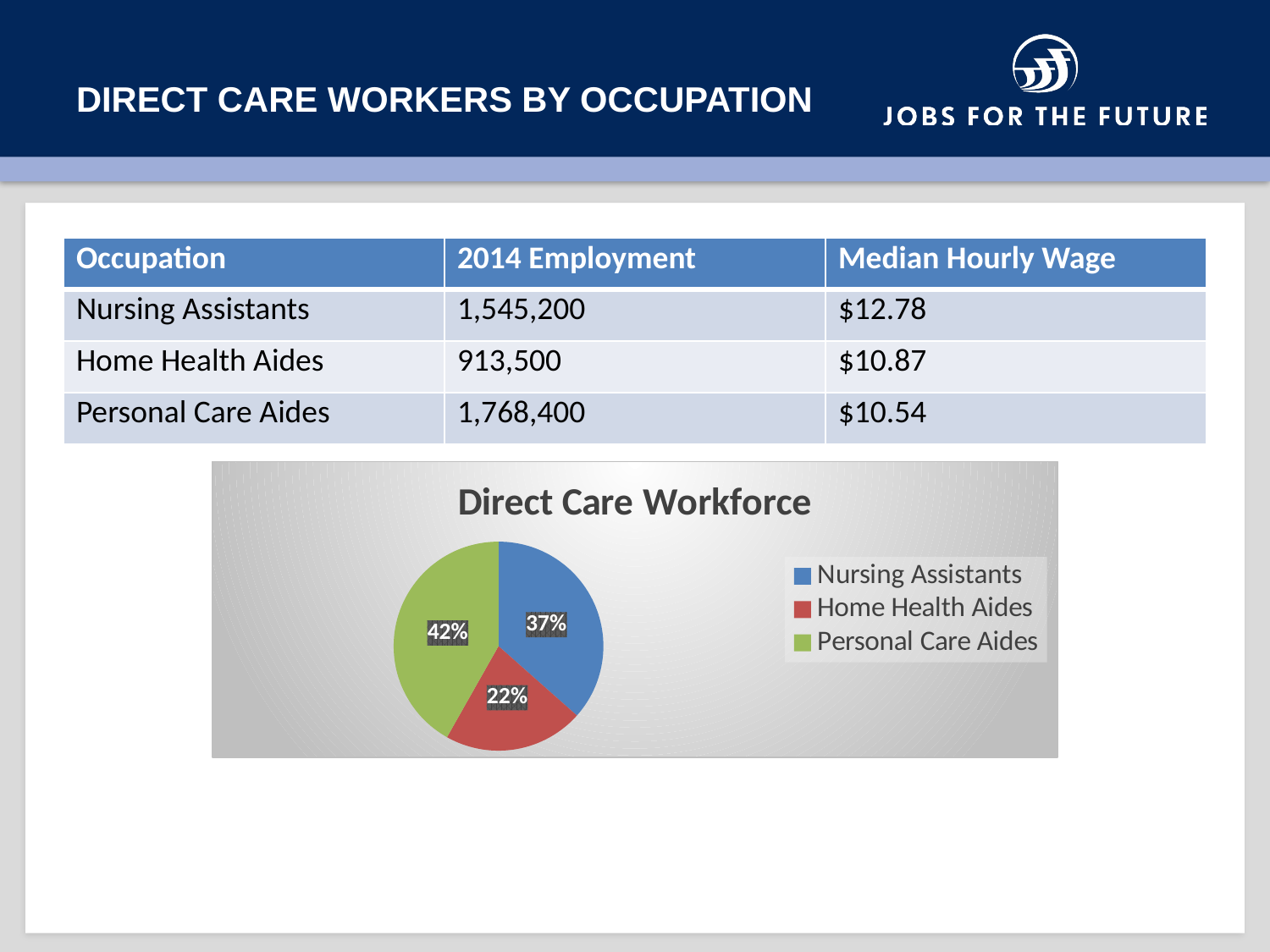
Which occupation has the largest slice in the Direct Care Workforce pie chart? Personal Care Aides In the Direct Care Workforce pie chart, what is the difference in percentage points between the Personal Care Aides slice and the Home Health Aides slice? 20 percentage points In the Direct Care Workforce pie chart, which is larger: the Nursing Assistants slice or the Home Health Aides slice? Nursing Assistants How many slices does the Direct Care Workforce pie chart have? 3 What share of the Direct Care Workforce pie is Nursing Assistants? 37% What share of the Direct Care Workforce pie is Personal Care Aides? 42% What kind of chart is the Direct Care Workforce chart? pie chart What is the title of the pie chart? Direct Care Workforce How many entries does the legend of the Direct Care Workforce pie chart list? 3 What colour is the Home Health Aides slice in the Direct Care Workforce pie chart? red What share of the Direct Care Workforce pie is Home Health Aides? 22% Which occupation has the smallest slice in the Direct Care Workforce pie chart? Home Health Aides